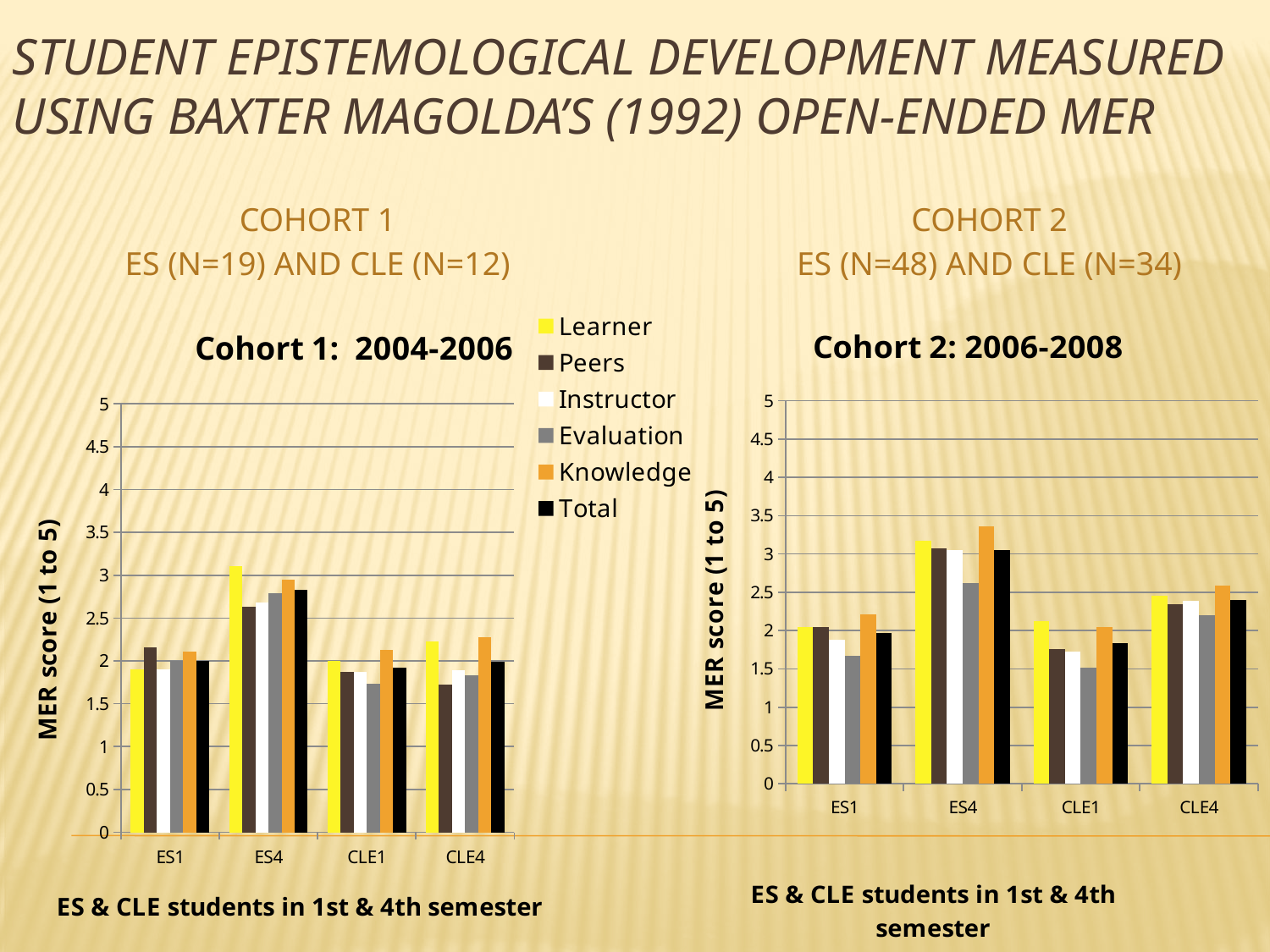
In the "Cohort 1: 2004-2006" chart, is the Total value for ES4 greater or less than 3? less How many categories are shown on the x axis of the "Cohort 2: 2006-2008" chart? 4 What kind of chart is the "Cohort 1: 2004-2006" chart? bar chart In the "Cohort 2: 2006-2008" chart, is the Knowledge value for ES4 greater or less than 3? greater In the "Cohort 2: 2006-2008" chart, which category has the highest Total value? ES4 In the "Cohort 1: 2004-2006" chart, is the Knowledge value larger for ES4 or for CLE4? ES4 How many series does the legend list for the charts on the slide? 6 In the "Cohort 1: 2004-2006" chart, which category has the highest Total value? ES4 In the "Cohort 2: 2006-2008" chart, is the Evaluation value for ES1 greater or less than 1.5? greater What is the y-axis title of the "Cohort 2: 2006-2008" chart? MER score (1 to 5) In the "Cohort 2: 2006-2008" chart, which category has the lowest Total value? CLE1